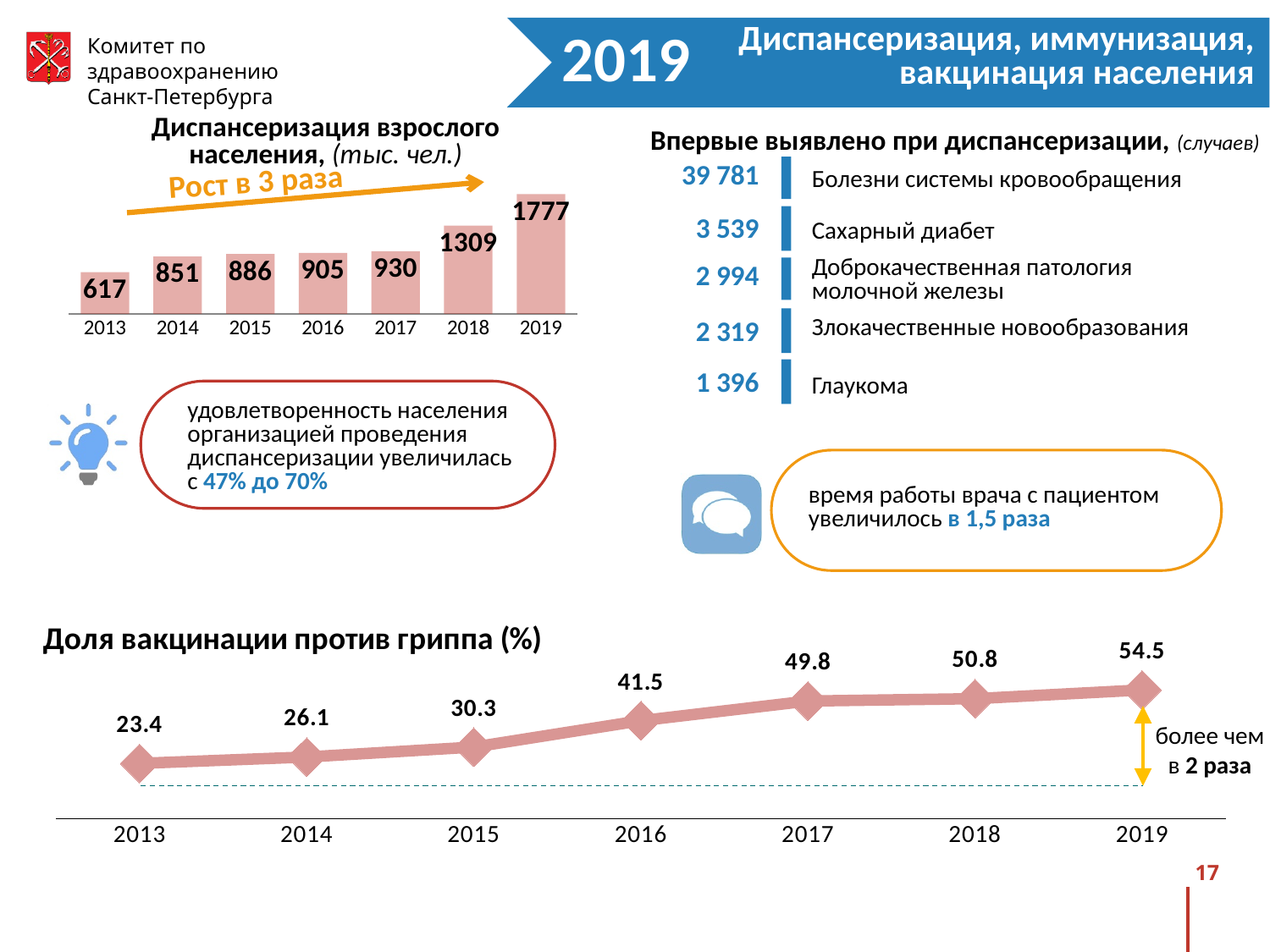
In the bar chart 'Диспансеризация взрослого населения', how many years are shown on the x axis? 7 What type of chart is 'Диспансеризация взрослого населения'? bar chart In the bar chart 'Диспансеризация взрослого населения', which year has the highest value? 2019 In the bar chart 'Диспансеризация взрослого населения', what is the value for 2013? 617 In the line chart 'Доля вакцинации против гриппа (%)', which is larger, the value for 2017 or the value for 2015? 2017 In the line chart 'Доля вакцинации против гриппа (%)', do the values rise or fall from 2013 to 2019? rise In the bar chart 'Диспансеризация взрослого населения', what is the difference between the values for 2019 and 2018? 468 In the line chart 'Доля вакцинации против гриппа (%)', what is the value for 2016? 41.5 In the bar chart 'Диспансеризация взрослого населения', what is the value for 2019? 1777 In the line chart 'Доля вакцинации против гриппа (%)', what is the difference between the values for 2019 and 2013? 31.1 In the line chart 'Доля вакцинации против гриппа (%)', what is the value for 2019? 54.5 In the bar chart 'Диспансеризация взрослого населения', which year has the lowest value? 2013